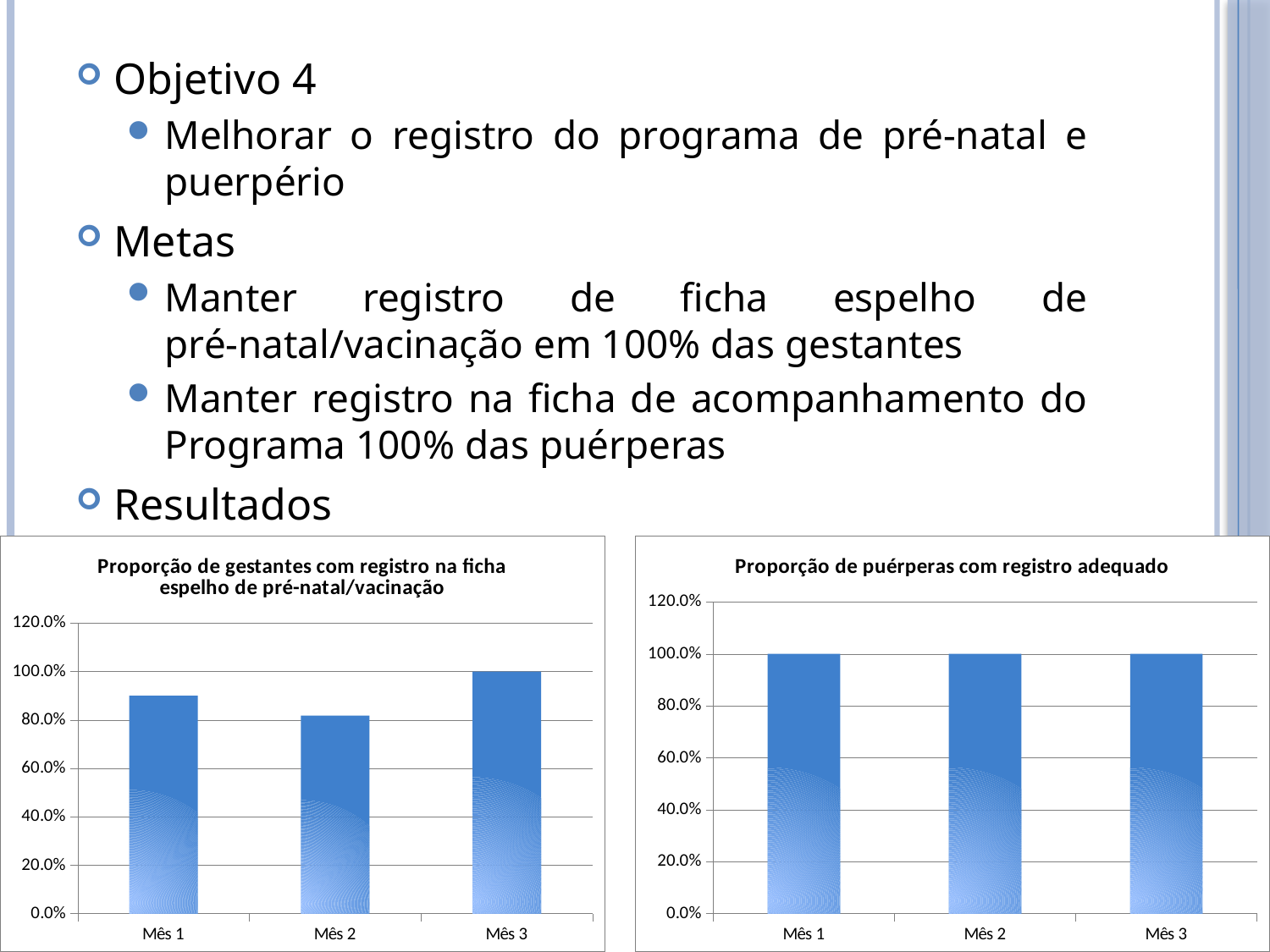
In the right chart, 'Proporção de puérperas com registro adequado', what is the value for Mês 3? 100.0% In the left chart, 'Proporção de gestantes com registro na ficha espelho de pré-natal/vacinação', which month has the lowest value? Mês 2 In the left chart, 'Proporção de gestantes com registro na ficha espelho de pré-natal/vacinação', which is larger, the value for Mês 1 or Mês 2? Mês 1 In the left chart, 'Proporção de gestantes com registro na ficha espelho de pré-natal/vacinação', is the value for Mês 2 greater or less than 100.0%? less In the left chart, 'Proporção de gestantes com registro na ficha espelho de pré-natal/vacinação', which month has the highest value? Mês 3 What kind of chart is the left chart, 'Proporção de gestantes com registro na ficha espelho de pré-natal/vacinação'? Bar chart How many categories are shown on the x axis of the right chart, 'Proporção de puérperas com registro adequado'? 3 In the left chart, 'Proporção de gestantes com registro na ficha espelho de pré-natal/vacinação', is the value for Mês 1 greater or less than 80.0%? greater In the right chart, 'Proporção de puérperas com registro adequado', what is the value for Mês 1? 100.0% In the left chart, 'Proporção de gestantes com registro na ficha espelho de pré-natal/vacinação', what is the value for Mês 3? 100.0% In the right chart, 'Proporção de puérperas com registro adequado', do the values rise, fall or stay the same from Mês 1 to Mês 3? Stay the same What is the title of the right chart on the slide? Proporção de puérperas com registro adequado